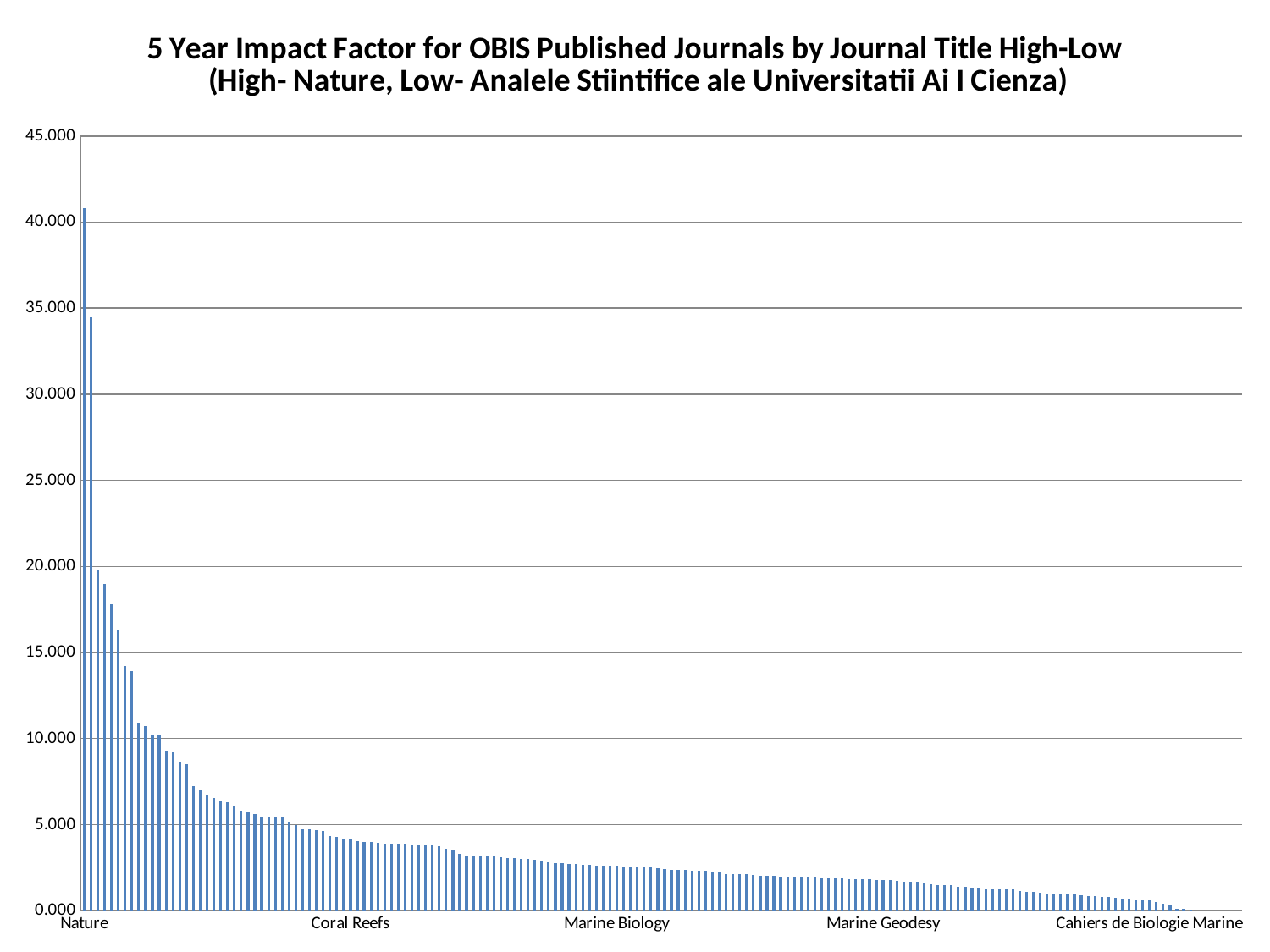
Which journal has the lowest 5 year impact factor in the chart? Analele Stiintifice ale Universitatii Ai I Cienza What is the title of the chart? 5 Year Impact Factor for OBIS Published Journals by Journal Title High-Low (High- Nature, Low- Analele Stiintifice ale Universitatii Ai I Cienza) Is the value for Cahiers de Biologie Marine greater or less than 5.000? less What kind of chart is shown on the slide? bar chart Is the value for Nature greater or less than 40.000? greater Do the values rise or fall moving from left to right along the x axis? fall Which has the larger 5 year impact factor, Marine Biology or Cahiers de Biologie Marine? Marine Biology Which journal has the highest 5 year impact factor in the chart? Nature Which has the larger 5 year impact factor, Nature or Coral Reefs? Nature Is the value for Coral Reefs greater or less than 10.000? less